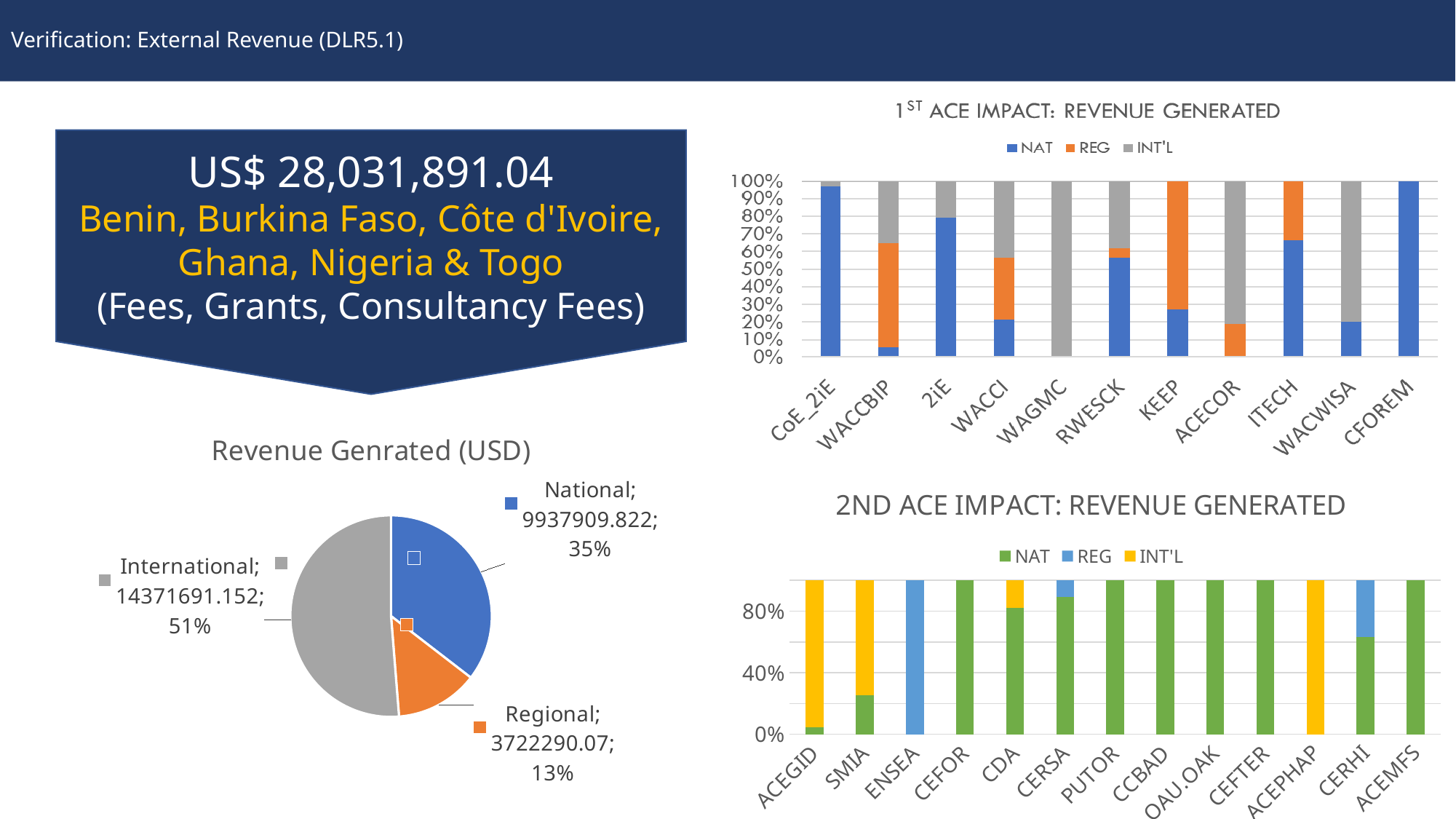
What type of chart is '2ND ACE IMPACT: REVENUE GENERATED'? Stacked bar chart In the pie chart 'Revenue Genrated (USD)', what is the value for Regional? 3722290.07 In the chart '2ND ACE IMPACT: REVENUE GENERATED', how many categories are shown on the x axis? 13 In the pie chart 'Revenue Genrated (USD)', how many slices are there? 3 In the pie chart 'Revenue Genrated (USD)', which category has the smallest slice? Regional In the pie chart 'Revenue Genrated (USD)', which is larger, National or International? International In the chart '1ST ACE IMPACT: REVENUE GENERATED', is the NAT value for WACCBIP greater or less than 10%? less In the chart '1ST ACE IMPACT: REVENUE GENERATED', is the NAT value for CoE_2iE greater or less than 90%? greater In the chart '1ST ACE IMPACT: REVENUE GENERATED', how many categories are shown on the x axis? 11 In the chart '1ST ACE IMPACT: REVENUE GENERATED', how many series does the legend list? 3 In the pie chart 'Revenue Genrated (USD)', what is the value for National? 9937909.822 In the pie chart 'Revenue Genrated (USD)', what share of the pie does International represent? 51%